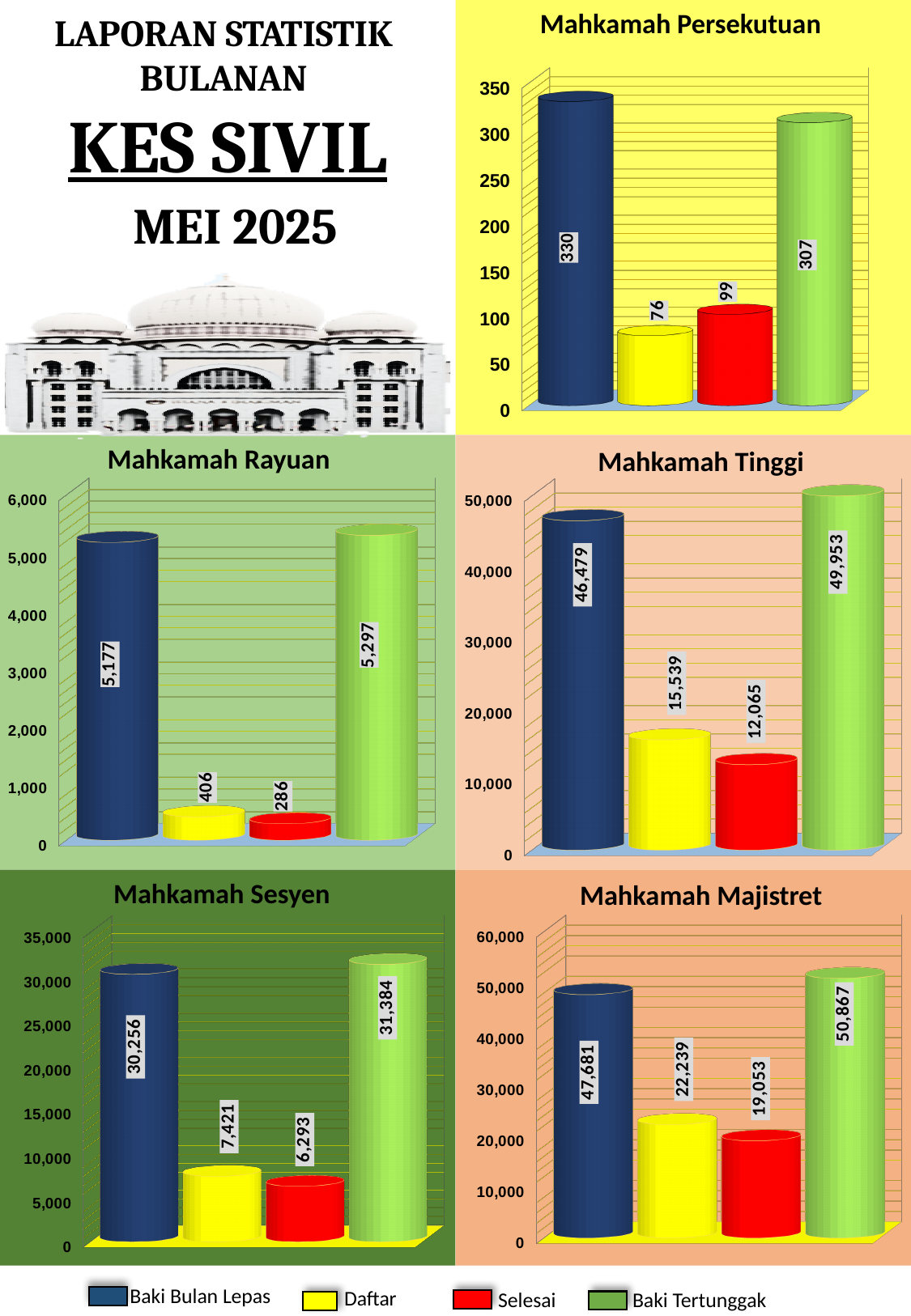
What kind of chart is the Mahkamah Tinggi chart? Bar chart In the Mahkamah Rayuan chart, what is the value for Daftar? 406 In the Mahkamah Sesyen chart, is the value for Daftar greater or less than 10,000? less In the Mahkamah Majistret chart, what is the value for Baki Tertunggak? 50,867 In the Mahkamah Tinggi chart, what is the value for Selesai? 12,065 How many bars are plotted in the Mahkamah Rayuan chart? 4 How many series does the legend at the bottom of the slide list? 4 In the Mahkamah Majistret chart, which is larger, Baki Bulan Lepas or Baki Tertunggak? Baki Tertunggak In the Mahkamah Persekutuan chart, which category has the lowest value? Daftar In the Mahkamah Persekutuan chart, what is the value for Baki Bulan Lepas? 330 In the Mahkamah Sesyen chart, which category has the highest value? Baki Tertunggak In the Mahkamah Tinggi chart, what is the difference between Daftar and Selesai? 3,474